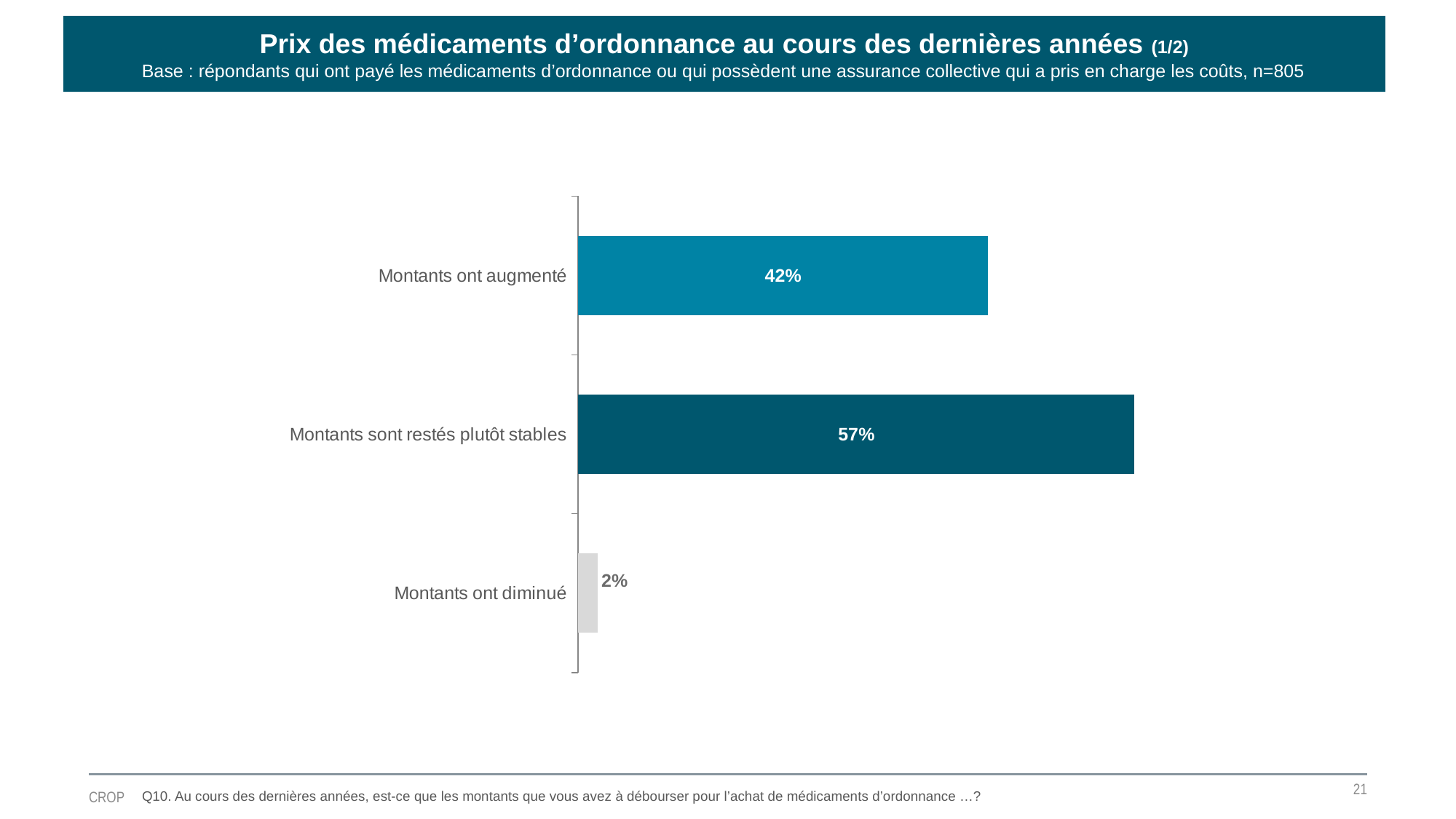
What is the value for "Montants sont restés plutôt stables"? 57% Which category has the lowest value? Montants ont diminué What kind of chart is shown on the slide? Bar chart Which is larger, "Montants ont augmenté" or "Montants ont diminué"? Montants ont augmenté What is the value for "Montants ont augmenté"? 42% What is the sample size (n) stated in the chart's base line? 805 Which category has the highest value? Montants sont restés plutôt stables What is the difference between "Montants ont augmenté" and "Montants ont diminué"? 40% What is the value for "Montants ont diminué"? 2% How many categories are shown in the chart? 3 What is the difference between "Montants sont restés plutôt stables" and "Montants ont augmenté"? 15% What colour is the bar for "Montants ont diminué"? Grey